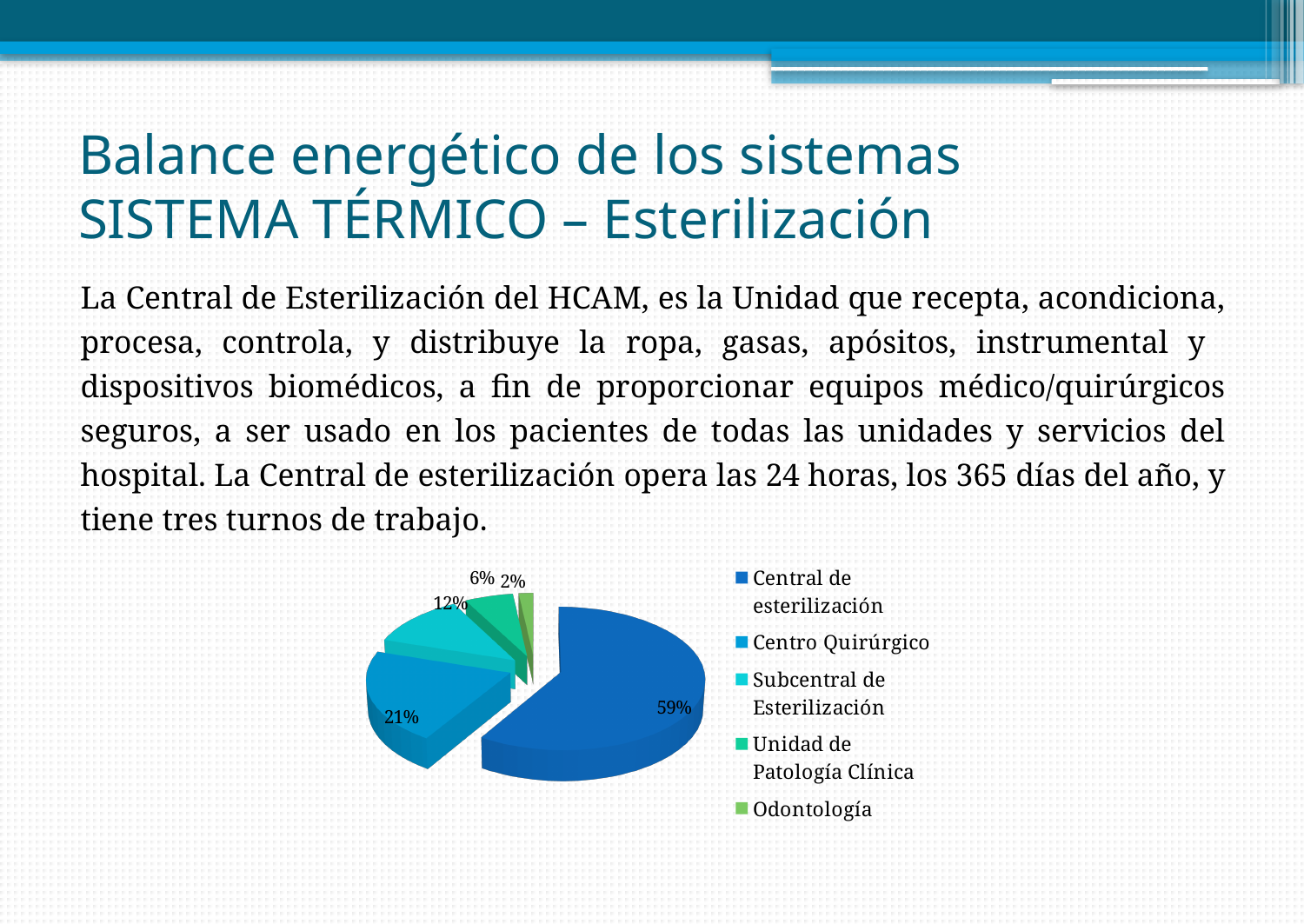
What is the difference in percentage points between Central de esterilización and Centro Quirúrgico? 38 Which category has the largest slice of the pie? Central de esterilización Which category has the smallest slice of the pie? Odontología What type of chart is shown on the slide? pie chart How many entries does the legend of the pie chart list? 5 What share of the pie does Odontología represent? 2% What share of the pie does Centro Quirúrgico represent? 21% What share of the pie does Unidad de Patología Clínica represent? 6% How many slices does the pie chart have? 5 Which is larger, the share for Subcentral de Esterilización or the share for Unidad de Patología Clínica? Subcentral de Esterilización